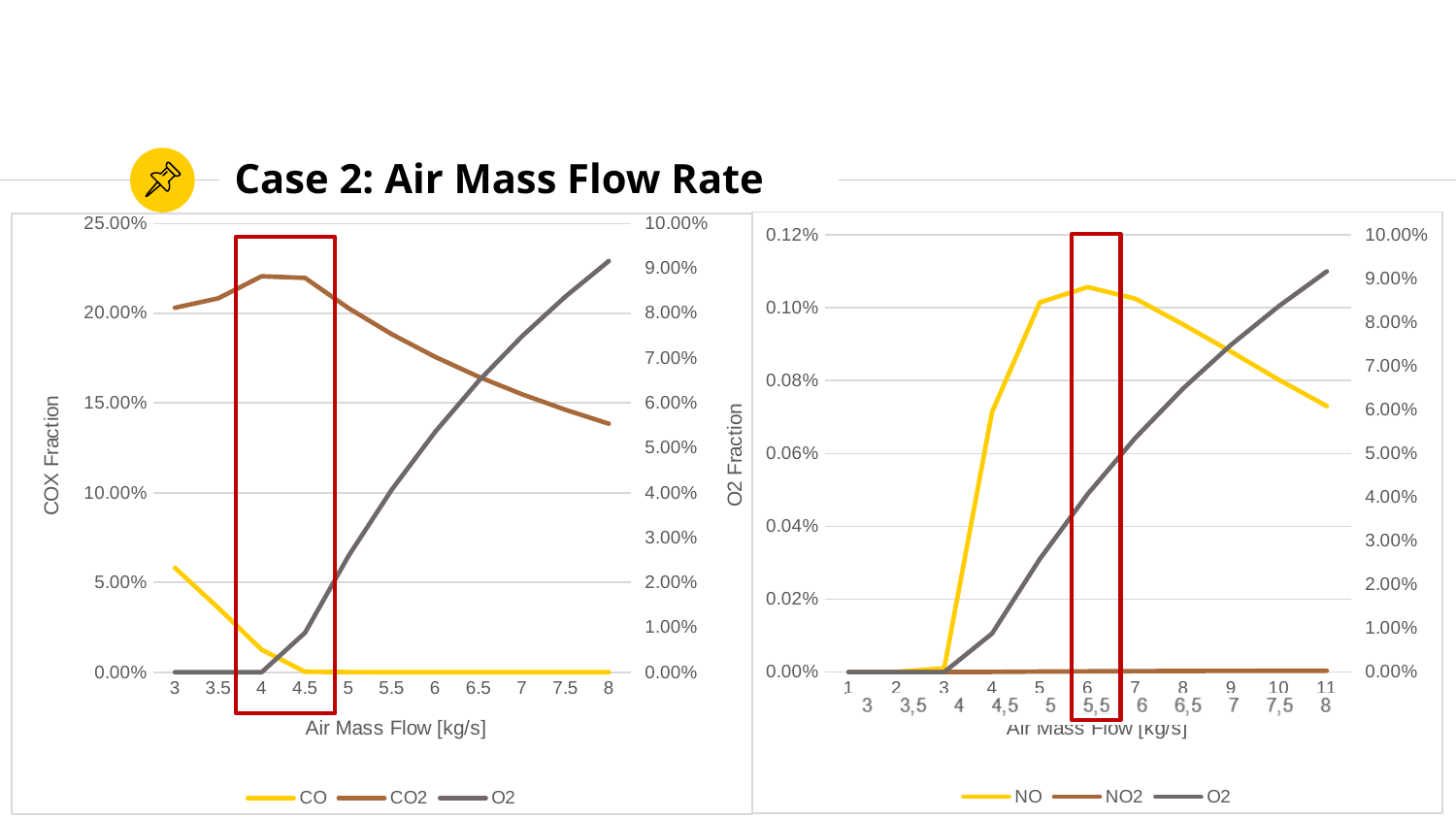
In the left chart (COX Fraction), does the CO line rise or fall as Air Mass Flow increases from 3 to 5 kg/s? fall In the right chart (NO/NO2/O2), which is larger at 6 kg/s, NO or NO2? NO How many series does the legend of the left chart (COX Fraction) list? 3 In the left chart (COX Fraction), is the O2 value at 8 kg/s greater or less than 8.00%? greater In the left chart (COX Fraction), which series reaches the highest value on the COX Fraction axis? CO2 What kind of chart is the left chart (COX Fraction)? line chart Which series are listed in the legend of the right chart (NO/NO2/O2)? NO, NO2, O2 In the left chart (COX Fraction), is the CO2 value at 4 kg/s greater or less than 20.00%? greater In the left chart (COX Fraction), is the CO2 value at 8 kg/s greater or less than 15.00%? less In the left chart (COX Fraction), does the O2 line rise or fall as Air Mass Flow increases? rise